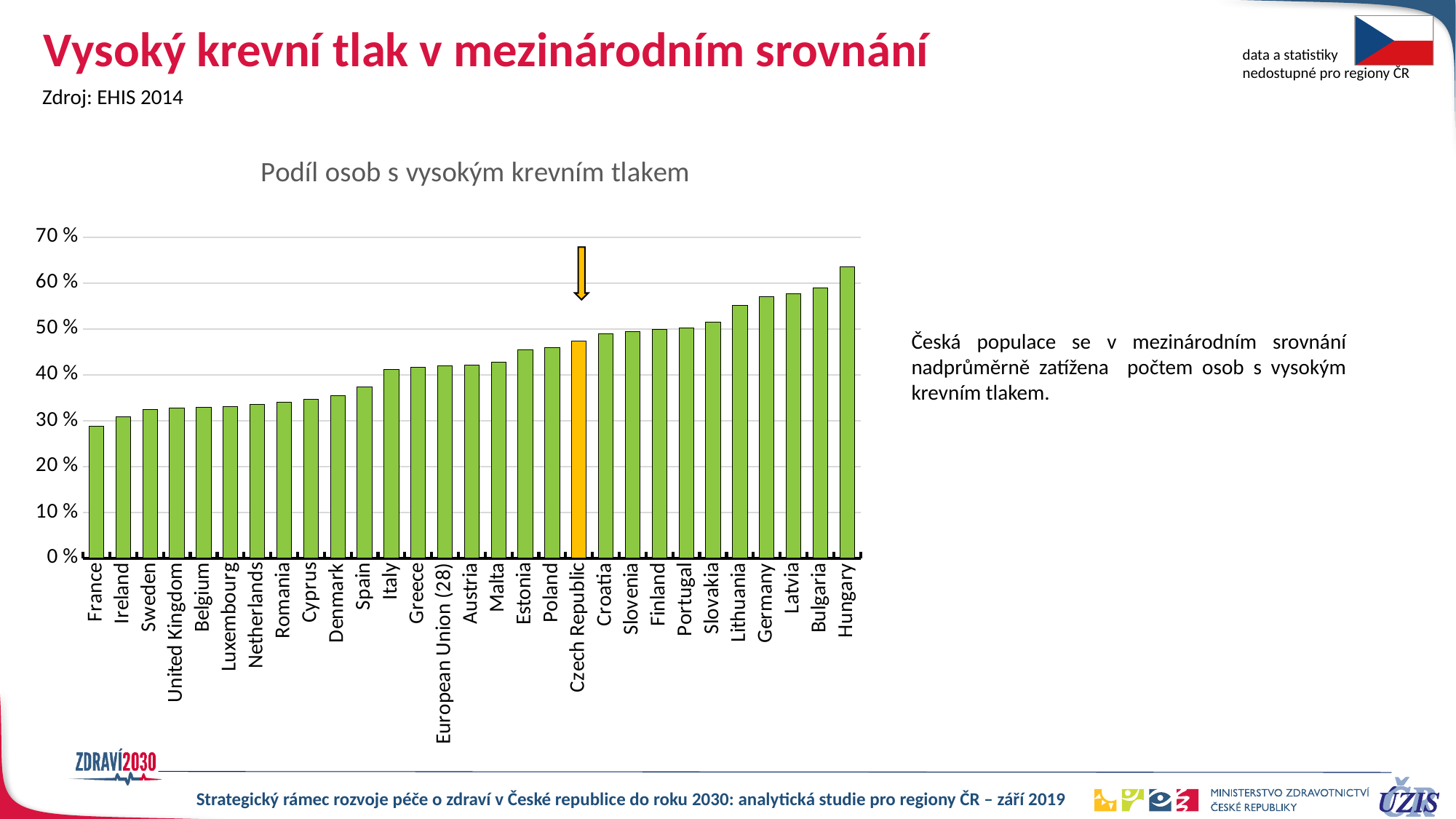
Which has a larger value, Czech Republic or European Union (28)? Czech Republic Is the value for France greater or less than 30 %? less What is the title of the chart? Podíl osob s vysokým krevním tlakem Is the value for Lithuania greater or less than 50 %? greater Which country has the highest share of persons with high blood pressure in the chart? Hungary Which has a larger value, Italy or Germany? Germany Which country has the lowest share of persons with high blood pressure in the chart? France How many categories (bars) are plotted in the chart? 29 Is the value for Czech Republic greater or less than 40 %? greater Do the values rise or fall from left to right along the x axis? Rise What kind of chart is shown on the slide? Bar chart